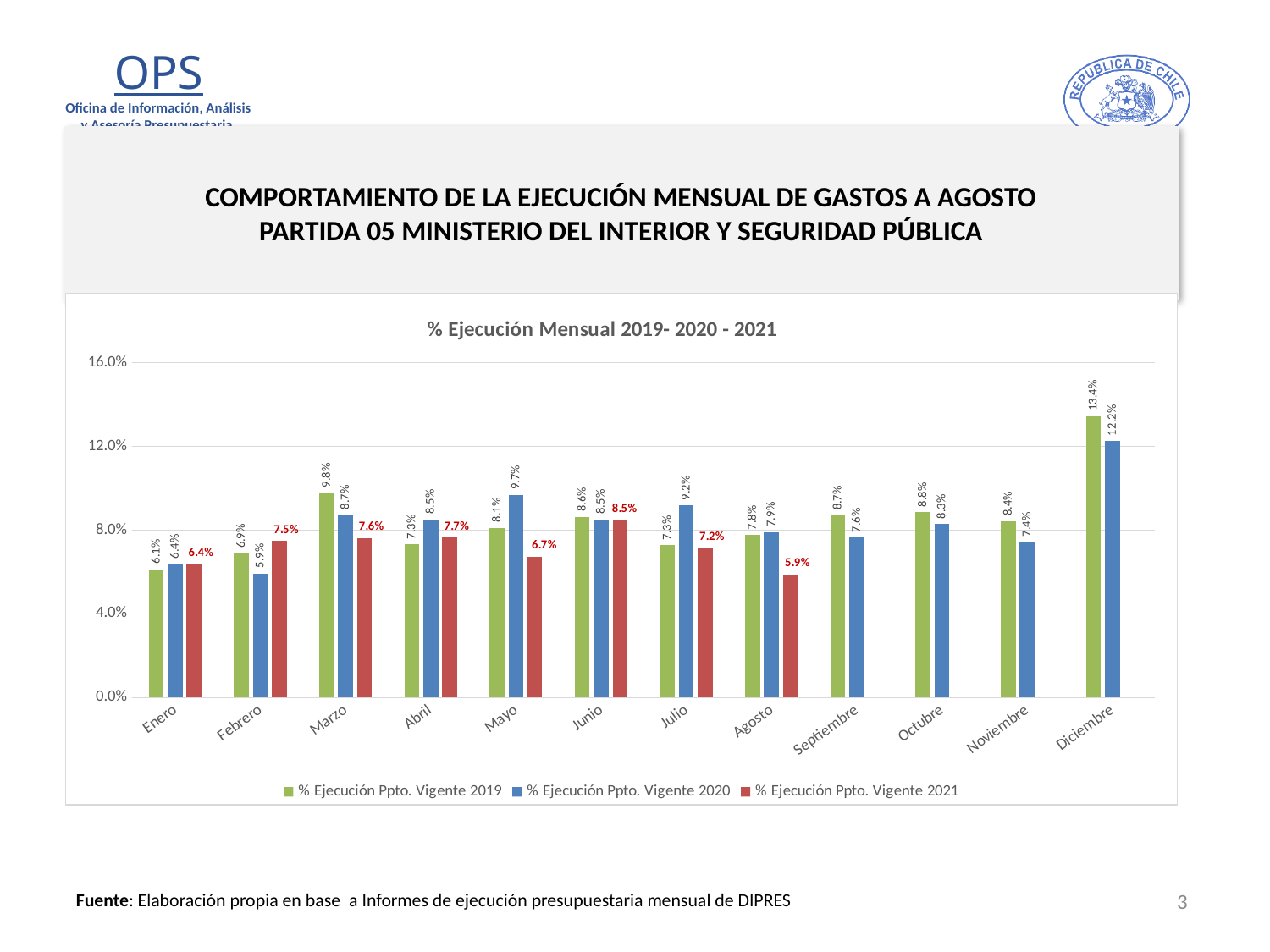
Which month has the lowest value for % Ejecución Ppto. Vigente 2021? Agosto In Julio, which is larger: the 2019 value or the 2020 value? 2020 What is the difference between the 2019 and 2020 values in Marzo? 1.1% How many series does the legend list? 3 What is the value for % Ejecución Ppto. Vigente 2019 in Diciembre? 13.4% Which month has the highest value for % Ejecución Ppto. Vigente 2020? Diciembre What is the value for % Ejecución Ppto. Vigente 2020 in Mayo? 9.7% How many months are shown on the x axis? 12 What is the value for % Ejecución Ppto. Vigente 2021 in Agosto? 5.9% What kind of chart is shown on the slide? Bar chart Is the value for % Ejecución Ppto. Vigente 2019 in Diciembre greater or less than 12.0%? greater What is the title of the chart? % Ejecución Mensual 2019- 2020 - 2021